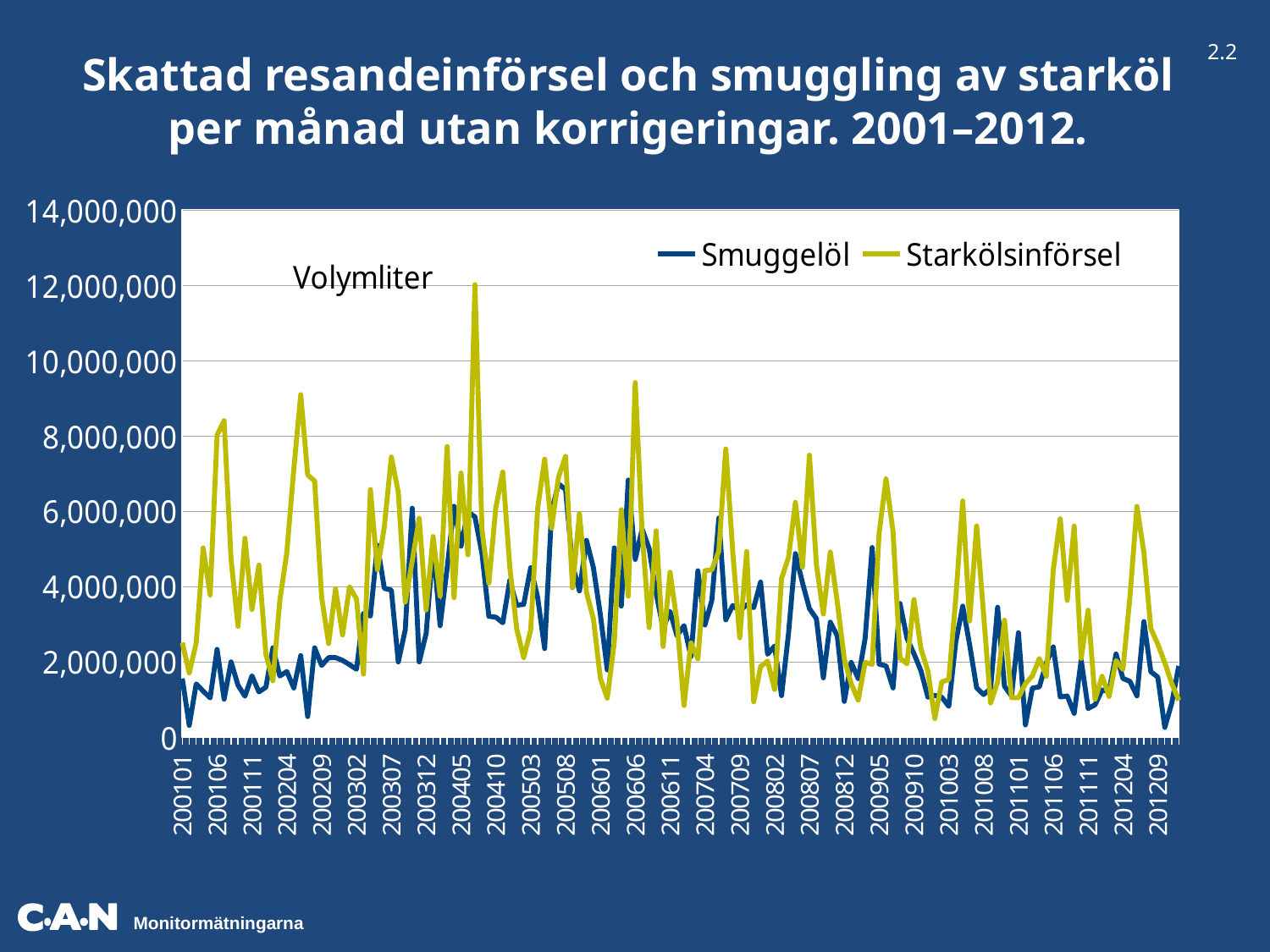
What unit label is shown inside the chart area? Volymliter At 200405, which series has the larger value, Smuggelöl or Starkölsinförsel? Starkölsinförsel How many years does the chart cover, according to the title? 12 Which series reaches the highest value anywhere in the chart? Starkölsinförsel What kind of chart is shown on the slide? Line chart Is the peak value for Starkölsinförsel around 200405 greater or less than 10,000,000? greater Is the value for Smuggelöl at 200101 greater or less than 2,000,000? less Is the highest value reached by Smuggelöl greater or less than 8,000,000? less What are the two series named in the legend? Smuggelöl and Starkölsinförsel What is the highest value shown on the y axis? 14,000,000 How many series does the legend list? 2